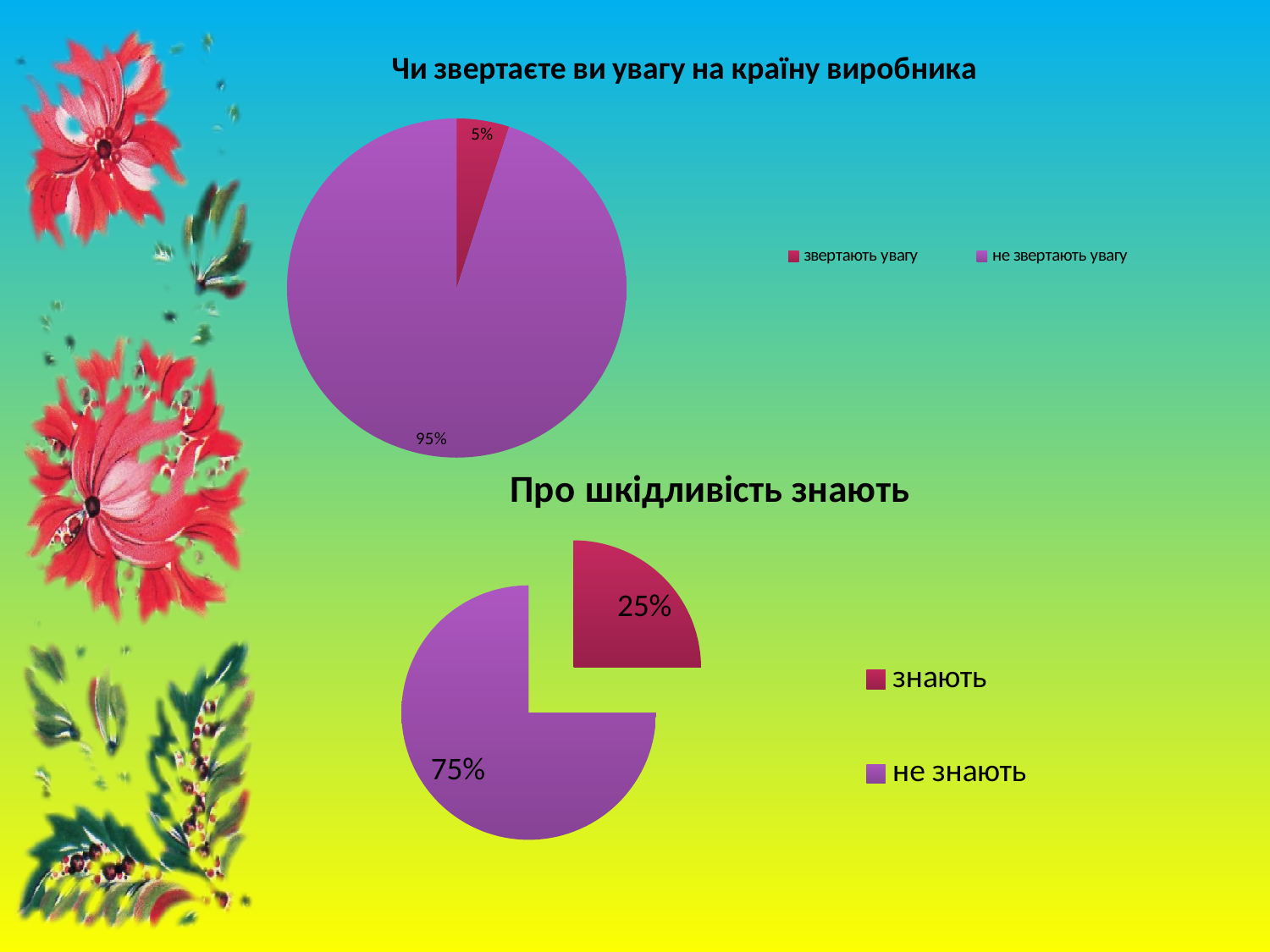
In the chart titled "Чи звертаєте ви увагу на країну виробника", how many entries does the legend list? 2 In the chart titled "Про шкідливість знають", how many slices does the pie have? 2 In the chart titled "Про шкідливість знають", what is the difference between "не знають" and "знають"? 50% What kind of chart is the chart titled "Про шкідливість знають"? pie chart In the chart titled "Про шкідливість знають", what share is labelled for "знають"? 25% In the chart titled "Чи звертаєте ви увагу на країну виробника", what share is labelled for "звертають увагу"? 5% In the chart titled "Чи звертаєте ви увагу на країну виробника", what share is labelled for "не звертають увагу"? 95% In the chart titled "Чи звертаєте ви увагу на країну виробника", what is the difference between the two slices? 90% In the chart titled "Чи звертаєте ви увагу на країну виробника", which category has the smallest slice? звертають увагу In the chart titled "Чи звертаєте ви увагу на країну виробника", which category has the largest slice? не звертають увагу In the chart titled "Про шкідливість знають", what share is labelled for "не знають"? 75% In the chart titled "Про шкідливість знають", which is larger, "знають" or "не знають"? не знають